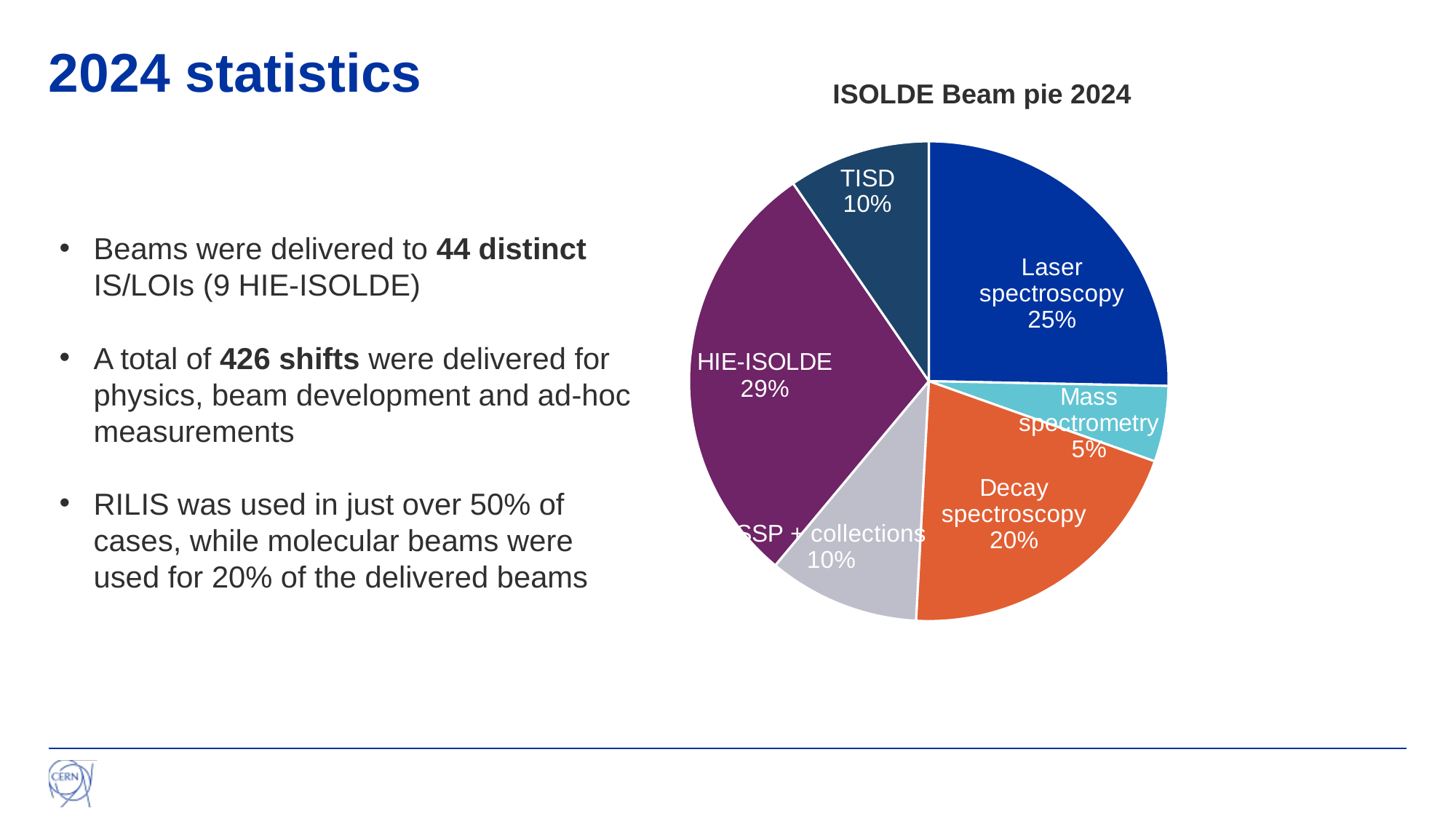
What share of the ISOLDE Beam pie 2024 is Laser spectroscopy? 25% What percentage does Decay spectroscopy account for in the ISOLDE Beam pie 2024? 20% What kind of chart is shown on the slide? Pie chart What percentage is shown for TISD in the ISOLDE Beam pie 2024? 10% How many slices does the ISOLDE Beam pie 2024 have? 6 Which is larger in the ISOLDE Beam pie 2024, Decay spectroscopy or Laser spectroscopy? Laser spectroscopy Which category has the smallest slice in the ISOLDE Beam pie 2024? Mass spectrometry What is the title of the chart on the slide? ISOLDE Beam pie 2024 Which category has the largest slice in the ISOLDE Beam pie 2024? HIE-ISOLDE What is the difference in percentage points between HIE-ISOLDE and Laser spectroscopy in the ISOLDE Beam pie 2024? 4 What percentage does Mass spectrometry account for in the ISOLDE Beam pie 2024? 5% What share of the ISOLDE Beam pie 2024 is HIE-ISOLDE? 29%